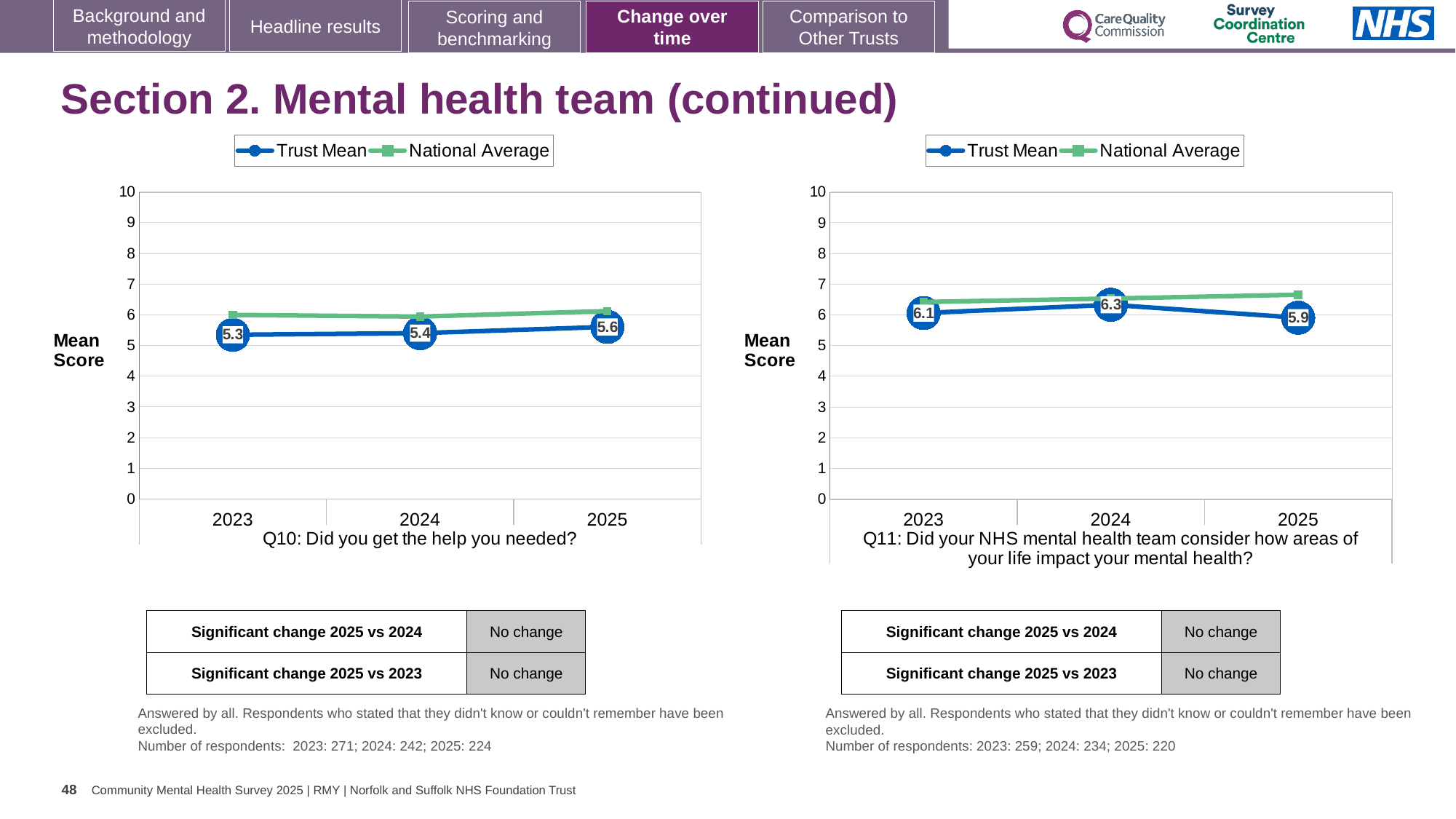
In the Q10 chart, which is larger in 2023, the Trust Mean or the National Average? National Average In the Q11 chart, which year has the highest Trust Mean? 2024 How many series does the legend of the Q10 chart list? 2 In the Q10 chart, what is the difference between the Trust Mean in 2025 and in 2023? 0.3 How many years are plotted on the x axis of the Q11 chart? 3 In the Q10 chart, which year has the lowest Trust Mean? 2023 What kind of chart is the Q11 chart? line chart In the Q10 chart, does the Trust Mean rise or fall from 2023 to 2025? rise In the Q11 chart, what is the Trust Mean for 2024? 6.3 In the Q10 chart, what is the Trust Mean for 2025? 5.6 In the Q11 chart, is the National Average for 2025 greater or less than 6? greater In the Q11 chart, what is the difference between the Trust Mean in 2024 and in 2025? 0.4